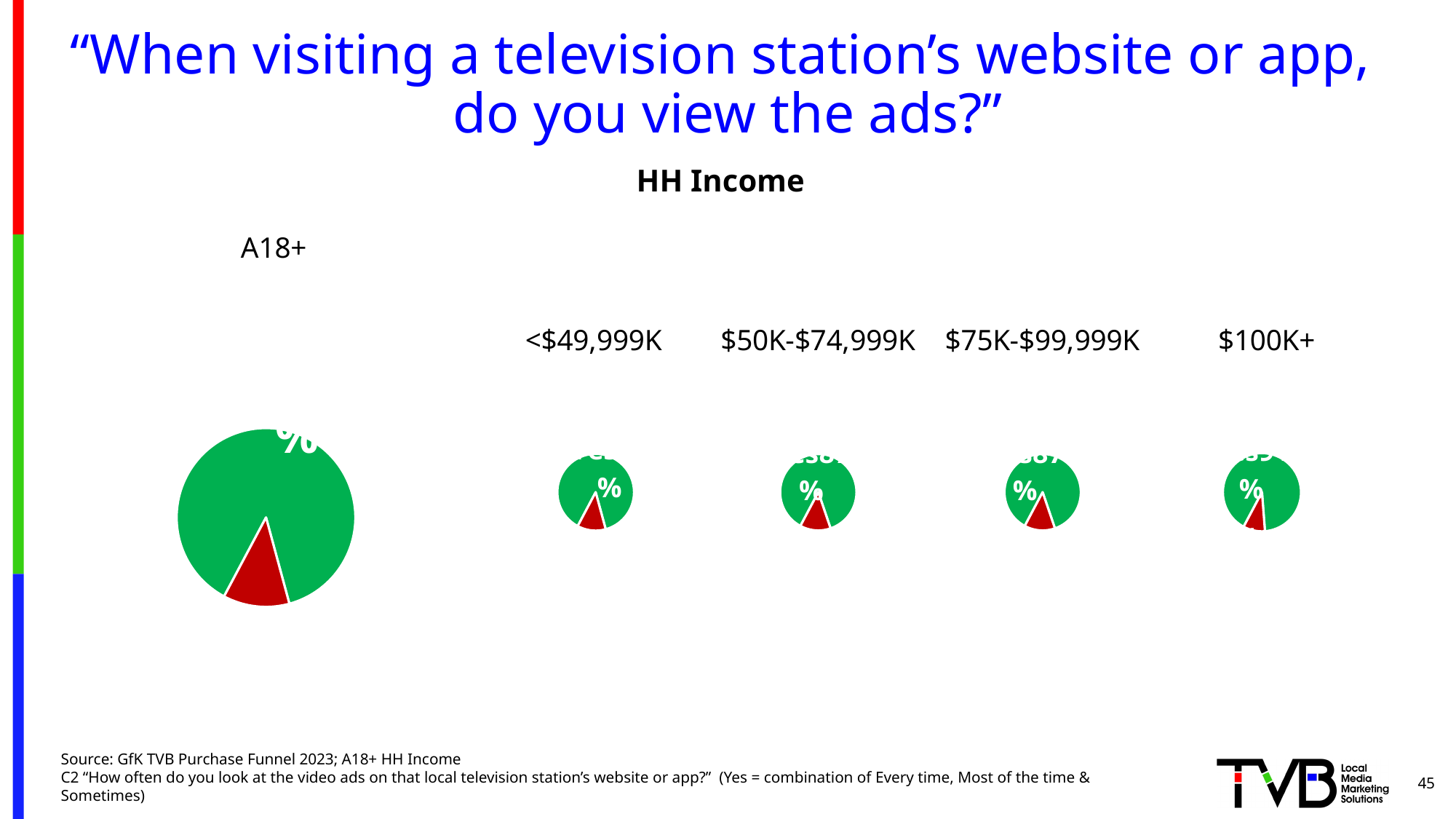
What is the label of the income group pie chart furthest to the right? $100K+ Which pie chart is drawn largest on the slide? A18+ What kind of chart is used to show the A18+ result on this slide? Pie chart In the <$49,999K pie chart, which slice is larger, the green slice or the red slice? Green In the $75K-$99,999K pie chart, does the green slice take up more or less than half of the pie? More In the $100K+ pie chart, which slice is smaller, the green slice or the red slice? Red What is the heading above the four income-group pie charts? HH Income How many household income categories are shown under the HH Income heading? 4 In the A18+ pie chart, which slice is larger, the green slice or the red slice? Green How many pie charts are shown on the slide? 5